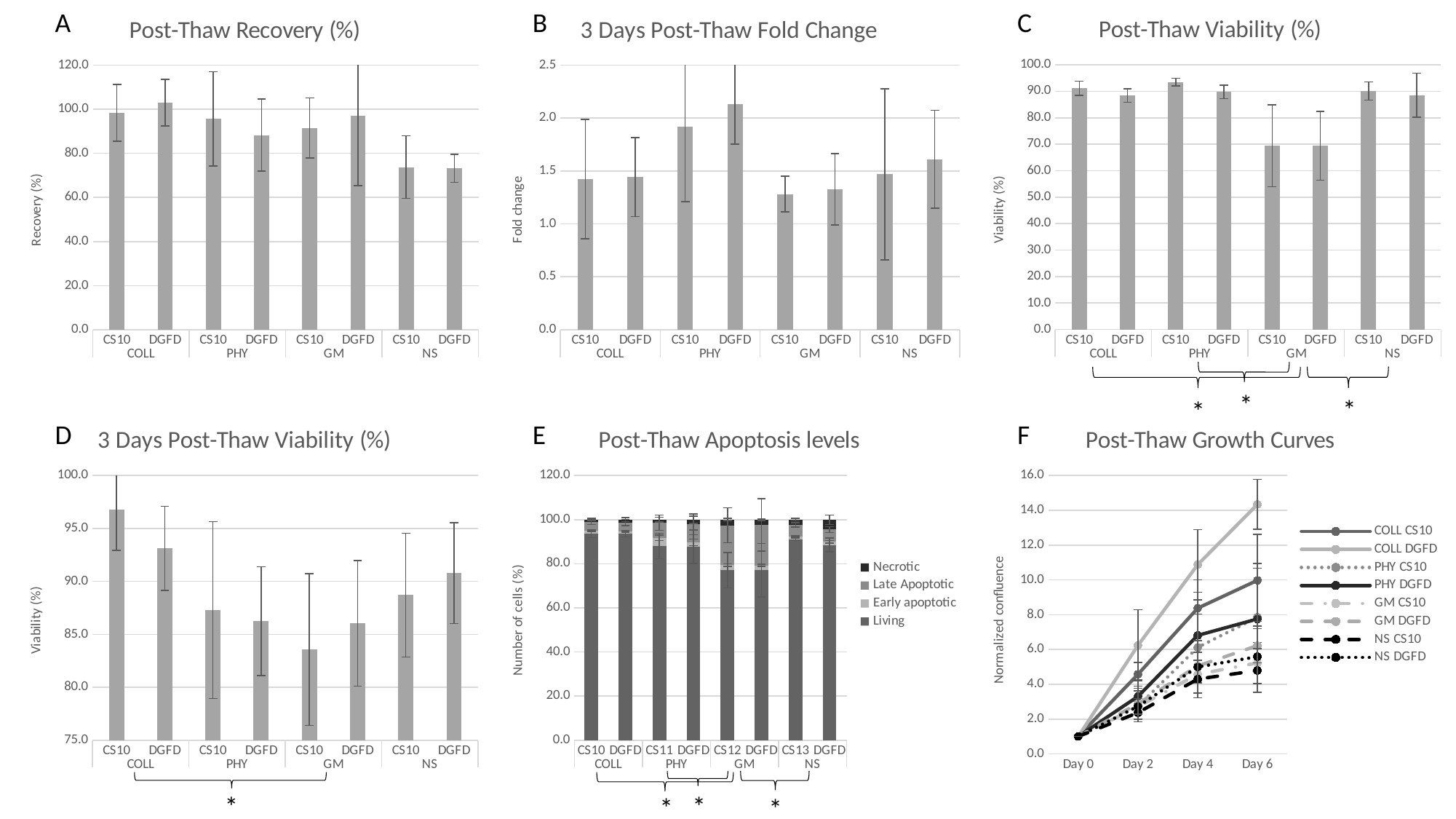
In the Post-Thaw Growth Curves chart, which series has the highest value at Day 6? COLL DGFD In the Post-Thaw Viability (%) chart, is the value for GM CS10 greater or less than 80.0? less What kind of chart is Post-Thaw Growth Curves? line chart In the Post-Thaw Apoptosis levels chart, how many series does the legend list? 4 In the 3 Days Post-Thaw Fold Change chart, is the value for GM CS10 greater or less than 1.5? less In the 3 Days Post-Thaw Fold Change chart, which bar is the highest? PHY DGFD In the 3 Days Post-Thaw Viability (%) chart, which bar is the highest? COLL CS10 In the Post-Thaw Viability (%) chart, which is larger, PHY CS10 or GM DGFD? PHY CS10 In the Post-Thaw Recovery (%) chart, is the value for NS CS10 greater or less than 80.0? less In the Post-Thaw Recovery (%) chart, how many bars are plotted? 8 In the 3 Days Post-Thaw Viability (%) chart, which bar is the lowest? GM CS10